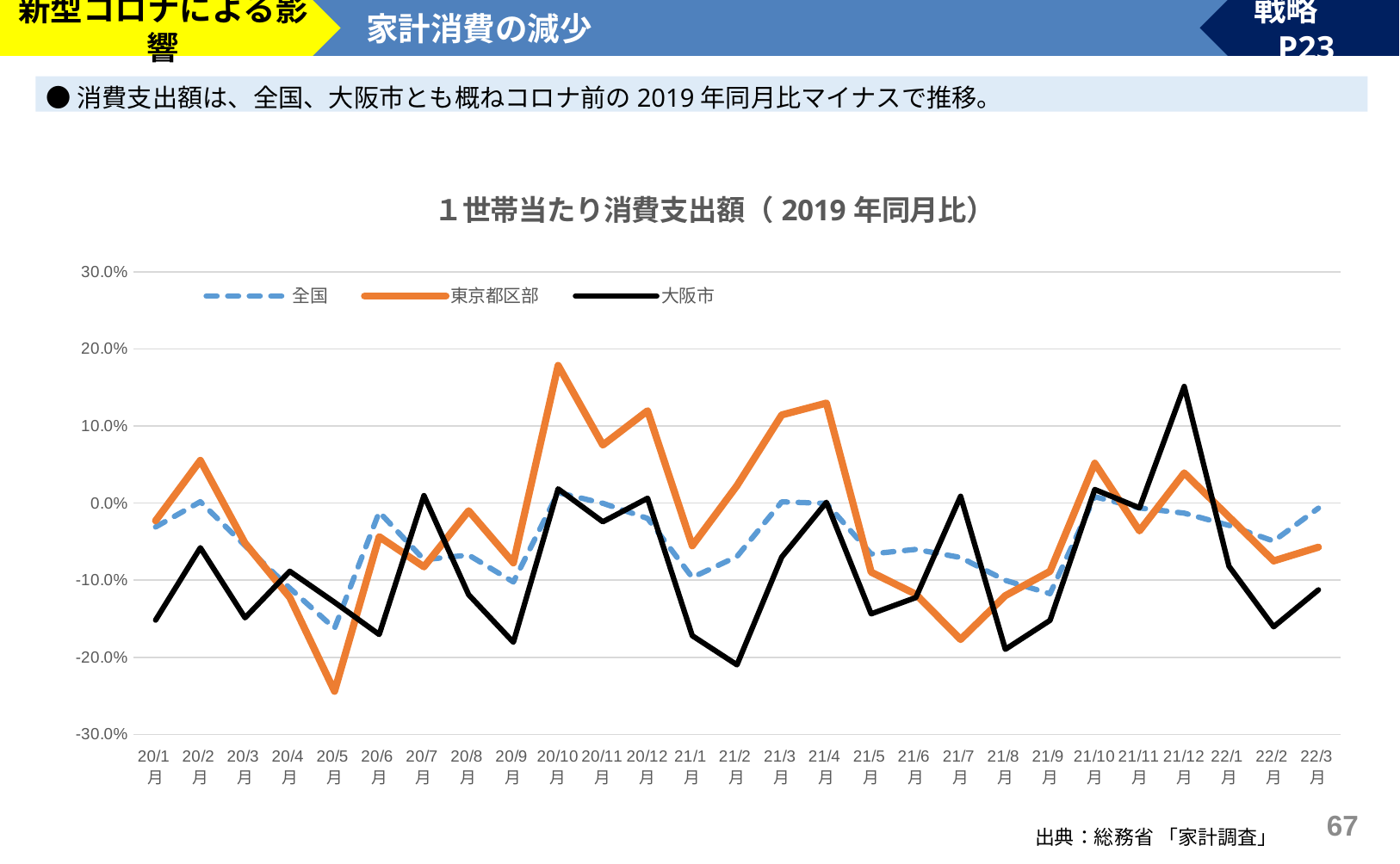
What is the title of the chart? １世帯当たり消費支出額（2019年同月比） How many series does the legend list? 3 Which series is drawn with a dashed blue line? 全国 Is the value for 全国 in 20/5月 greater or less than -10.0%? less Is the value for 大阪市 in 21/12月 greater or less than 10.0%? greater Which series has the lowest value in 20/5月? 東京都区部 Which series has the highest value in 21/12月? 大阪市 Which series has the highest value in 20/10月? 東京都区部 How many months (data points) are plotted along the x axis? 27 Is the value for 東京都区部 in 20/10月 greater or less than 10.0%? greater What kind of chart is shown on the slide? Line chart